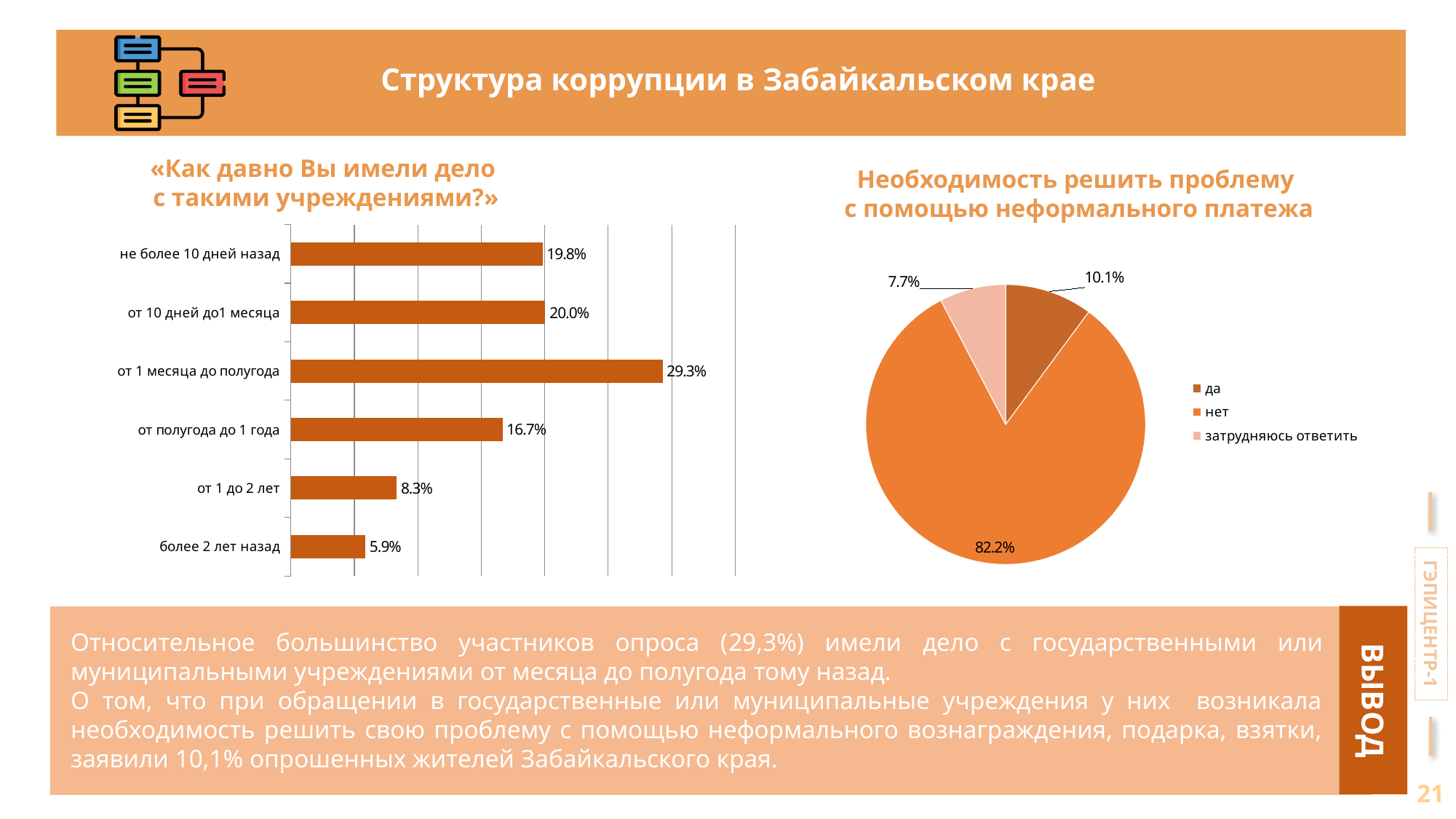
In the pie chart «Необходимость решить проблему с помощью неформального платежа», what is the value for «да»? 10.1% How many entries does the legend of the pie chart «Необходимость решить проблему с помощью неформального платежа» list? 3 In the pie chart «Необходимость решить проблему с помощью неформального платежа», what share does «нет» have? 82.2% In the left chart «Как давно Вы имели дело с такими учреждениями?», what is the value for «от 1 месяца до полугода»? 29.3% In the left chart «Как давно Вы имели дело с такими учреждениями?», what is the difference between «от 10 дней до1 месяца» and «от 1 до 2 лет»? 11.7% In the left chart «Как давно Вы имели дело с такими учреждениями?», what is the value for «более 2 лет назад»? 5.9% In the left chart «Как давно Вы имели дело с такими учреждениями?», which is larger: «не более 10 дней назад» or «от полугода до 1 года»? не более 10 дней назад In the left chart «Как давно Вы имели дело с такими учреждениями?», which category has the lowest value? более 2 лет назад What kind of chart is the left chart «Как давно Вы имели дело с такими учреждениями?»? bar chart In the left chart «Как давно Вы имели дело с такими учреждениями?», which category has the highest value? от 1 месяца до полугода In the pie chart «Необходимость решить проблему с помощью неформального платежа», which slice is the smallest? затрудняюсь ответить How many categories are shown in the left chart «Как давно Вы имели дело с такими учреждениями?»? 6